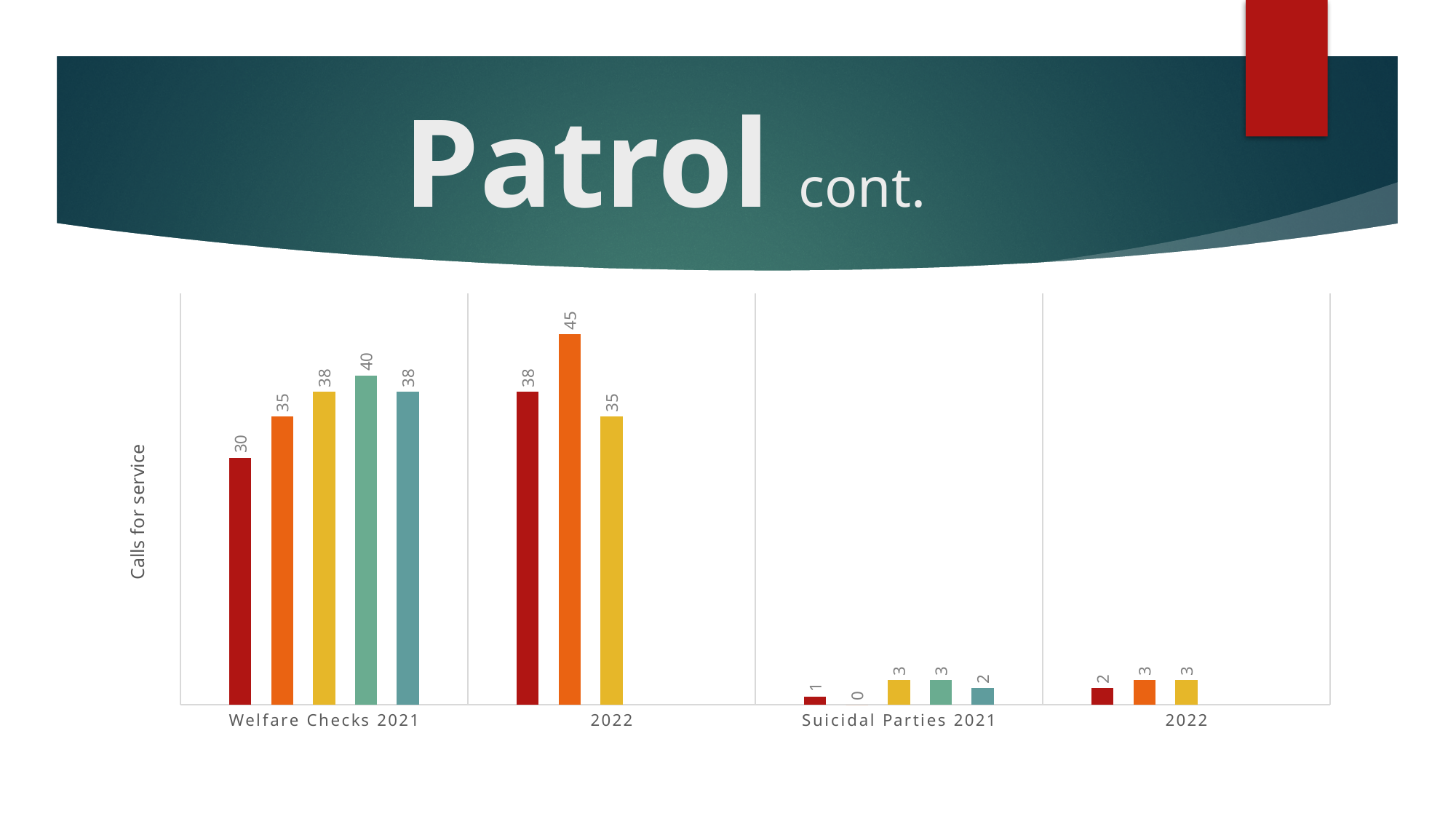
What is the value of the dark red bar in the 2022 group following Suicidal Parties 2021? 2 What type of chart is shown on the slide? bar chart What is the difference between the orange bar in the 2022 group after Welfare Checks 2021 (45) and the dark red bar in that same group (38)? 7 What is the value of the highest bar in the Welfare Checks 2021 group? 40 What is the value of the lowest bar in the Welfare Checks 2021 group? 30 What is the value of the orange bar in the Suicidal Parties 2021 group? 0 What is the y-axis title of the chart? Calls for service What is the value of the tallest bar in the 2022 group next to Welfare Checks 2021? 45 How many bars are shown in the Suicidal Parties 2021 group? 5 What is the value of the first (dark red) bar in the Welfare Checks 2021 group? 30 How many categories are shown along the x axis? 4 Which is larger: the dark red bar in Welfare Checks 2021 or the dark red bar in the following 2022 group? the 2022 bar